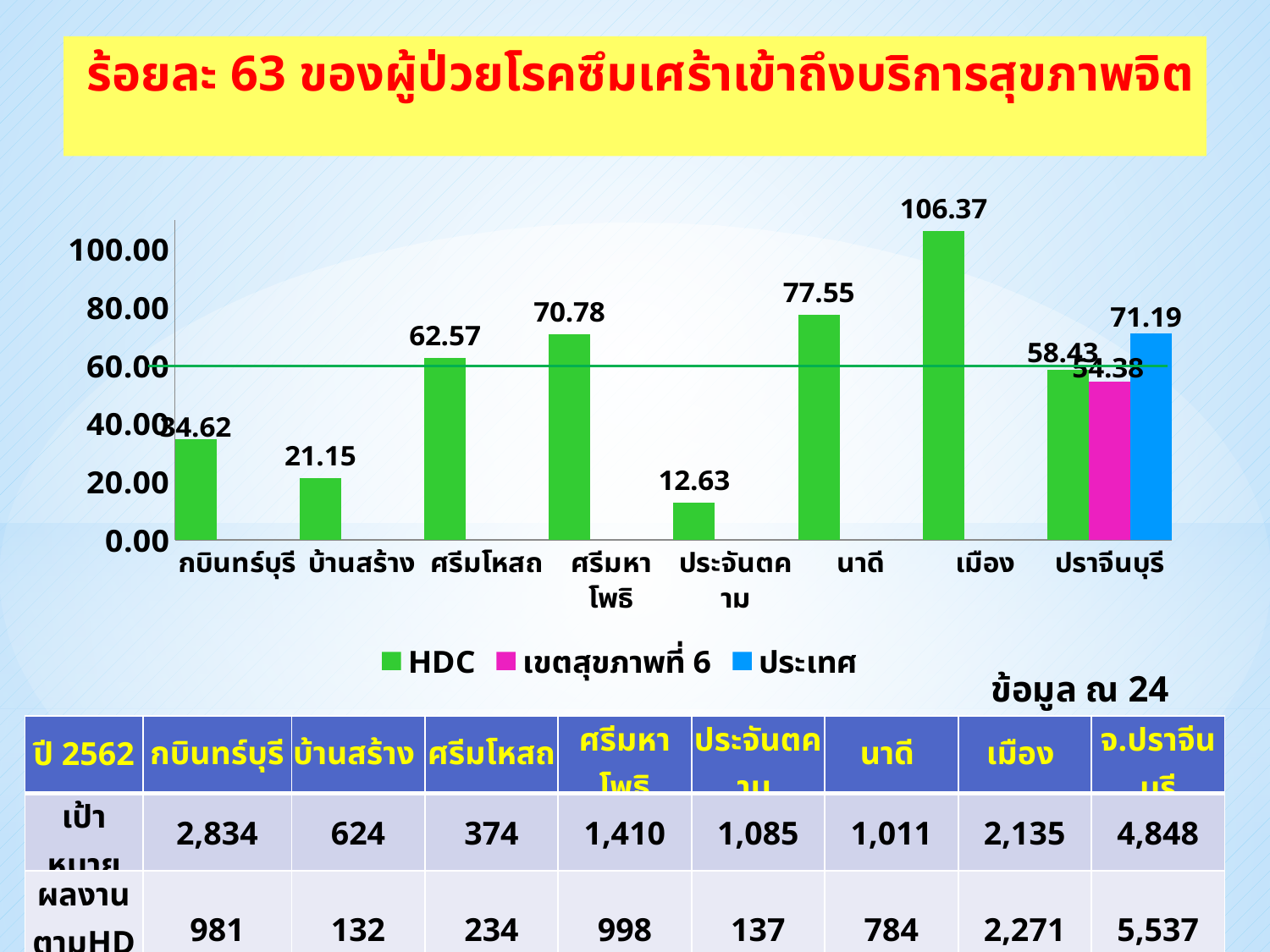
What type of chart is shown on the slide? bar chart What is the difference between the HDC values for นาดี and ศรีมหาโพธิ? 6.77 Which category has the highest HDC value? เมือง How many series does the chart legend list? 3 Which category has the lowest HDC value? ประจันตคาม What is the HDC value for เมือง? 106.37 Which has a higher HDC value, ศรีมโหสถ or บ้านสร้าง? ศรีมโหสถ Is the HDC value for กบินทร์บุรี greater or less than 40.00? less What is the value of the เขตสุขภาพที่ 6 series for ปราจีนบุรี? 54.38 What is the value of the ประเทศ series for ปราจีนบุรี? 71.19 How many categories are shown on the x axis of the chart? 8 What is the HDC value for ประจันตคาม? 12.63